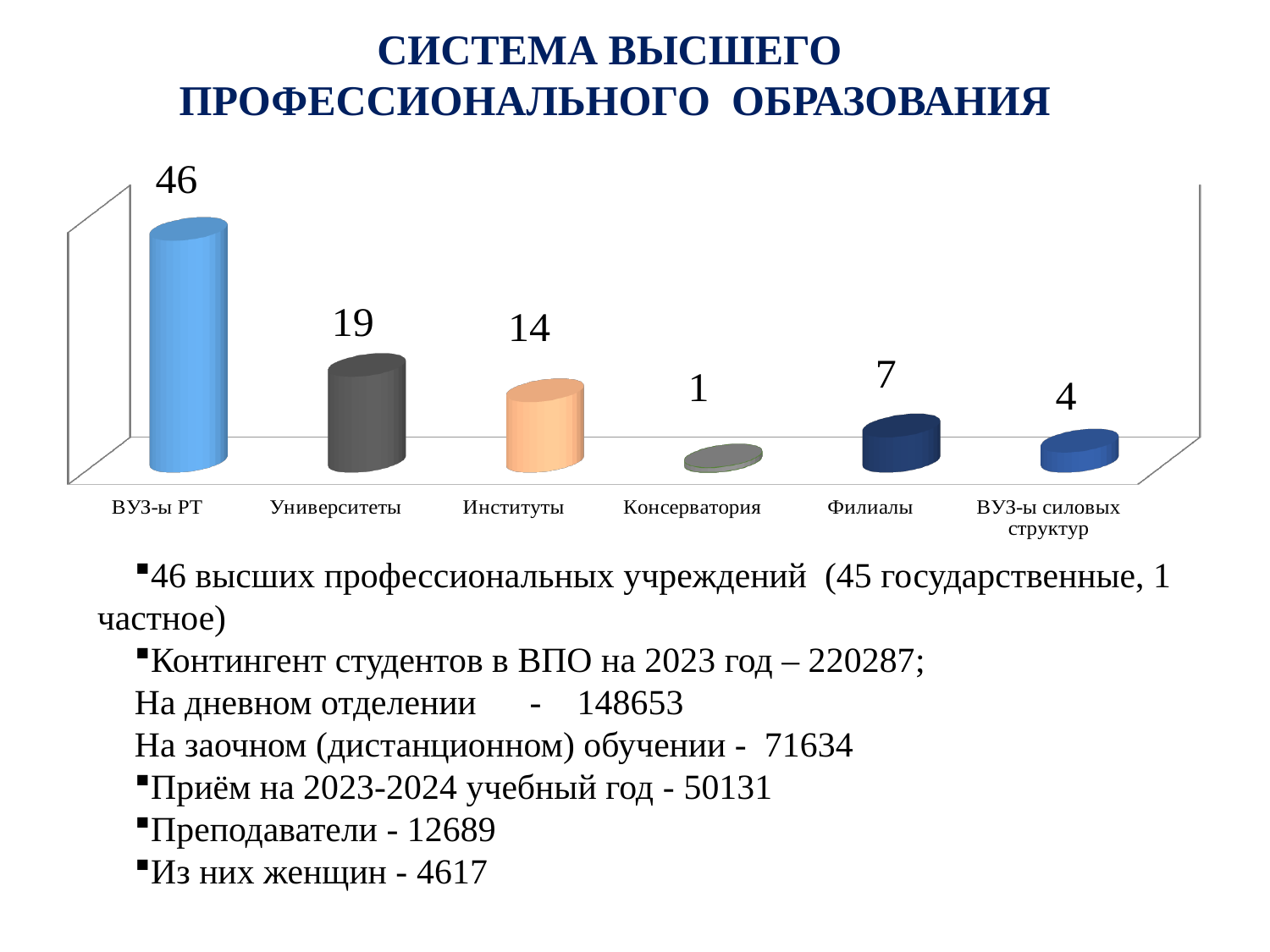
Which is larger, the value for Филиалы or the value for ВУЗ-ы силовых структур? Филиалы What is the value for Филиалы? 7 What is the difference between the values for ВУЗ-ы РТ and Университеты? 27 What is the value for Институты? 14 What is the difference between the values for Университеты and Институты? 5 Which category has the highest value? ВУЗ-ы РТ What is the value for ВУЗ-ы РТ? 46 How many categories are shown on the chart? 6 What is the value for ВУЗ-ы силовых структур? 4 What is the value for Университеты? 19 What kind of chart is shown on the slide? bar chart Which category has the lowest value? Консерватория